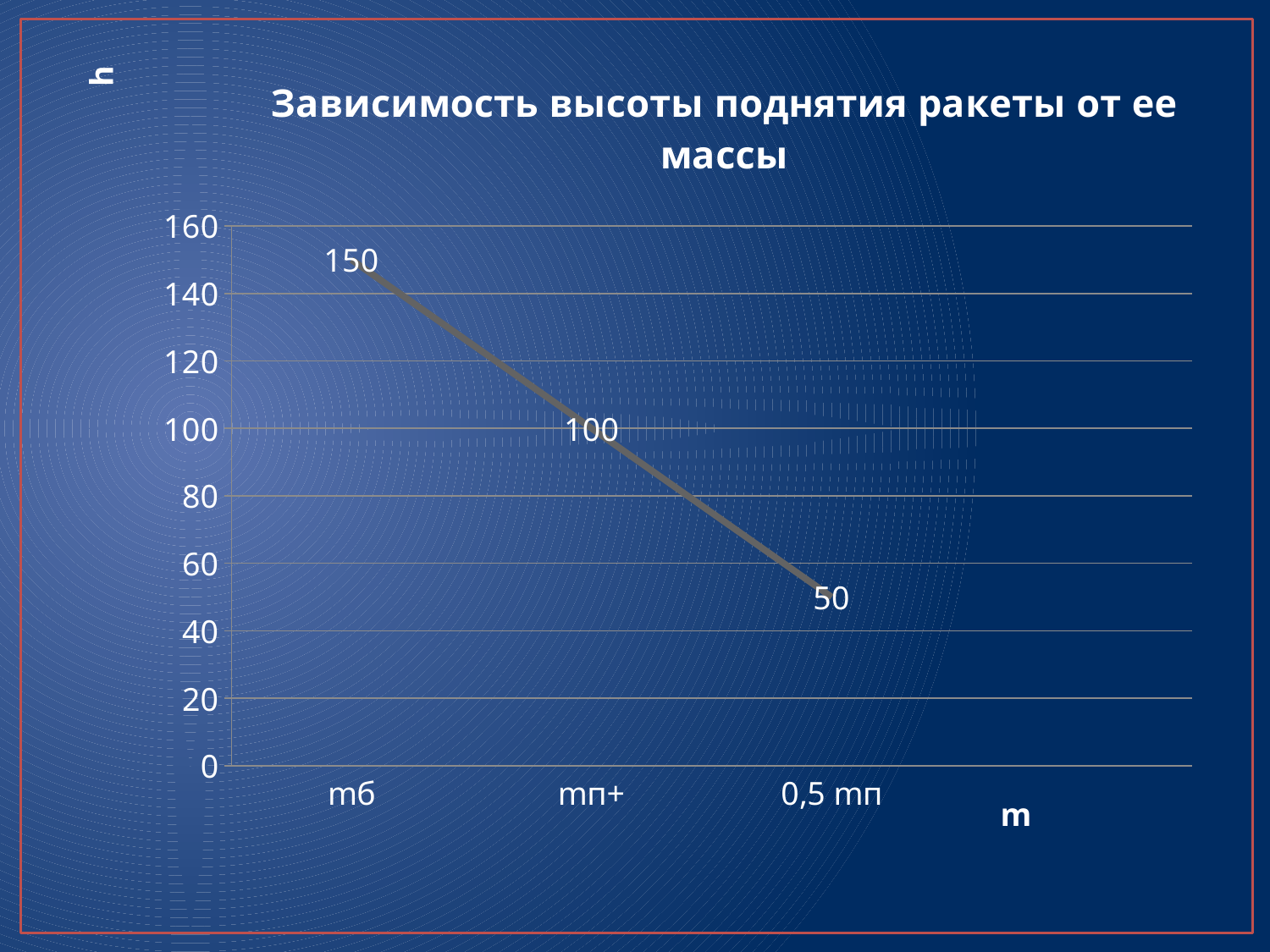
What is the value for mп+? 100 Do the values rise or fall along the x axis? fall What is the title of the chart? Зависимость высоты поднятия ракеты от ее массы How many categories are shown on the x axis? 3 Which is larger, the value for mп+ or the value for 0,5 mп? mп+ What is the difference between the values for mб and mп+? 50 What kind of chart is this? line chart What is the difference between the values for mб and 0,5 mп? 100 What is the value for 0,5 mп? 50 What is the value for mб? 150 Which category has the lowest value? 0,5 mп Which category has the highest value? mб